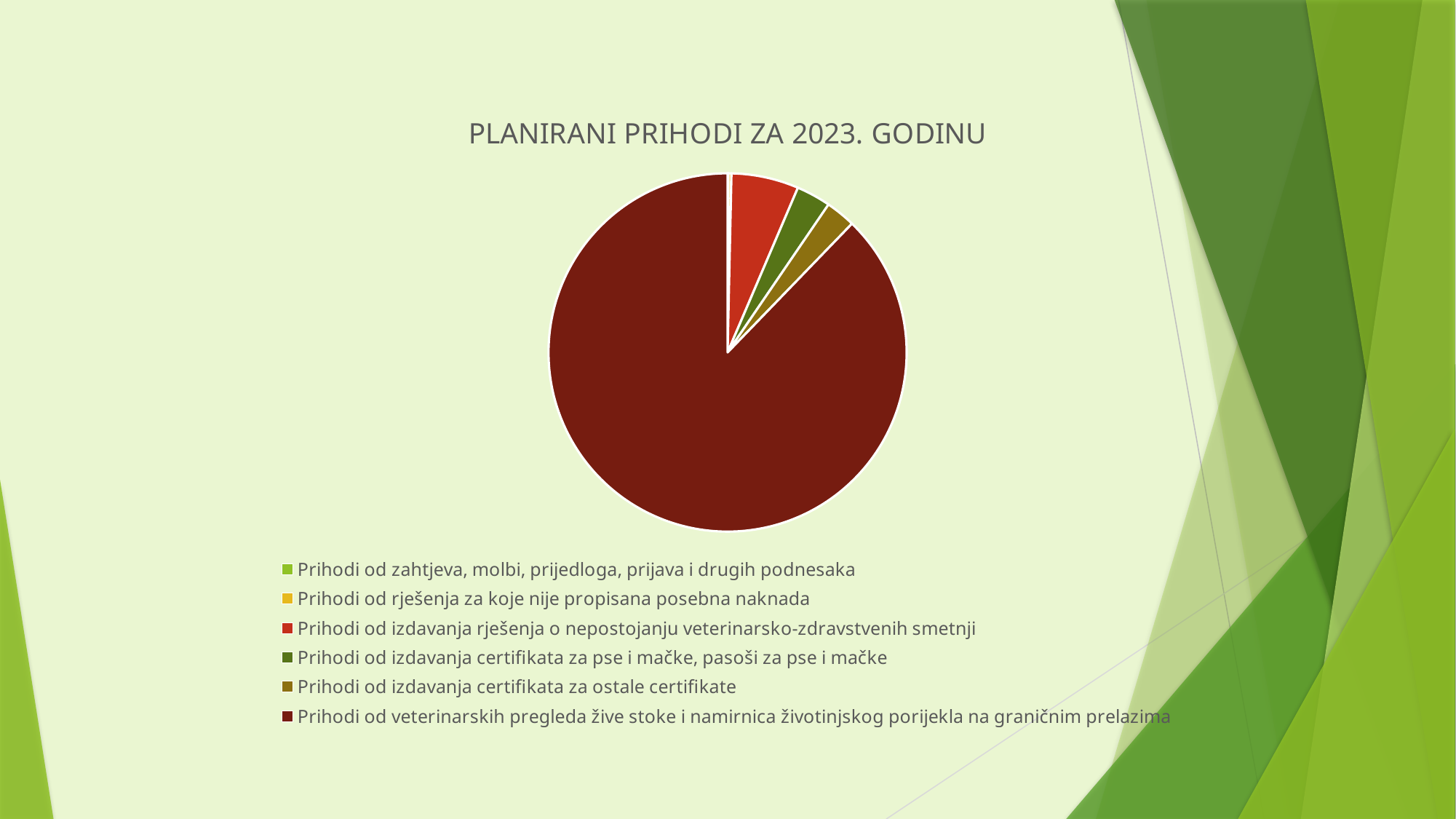
Which category has the largest slice of the pie? Prihodi od veterinarskih pregleda žive stoke i namirnica životinjskog porijekla na graničnim prelazima Which slice is larger: "Prihodi od izdavanja rješenja o nepostojanju veterinarsko-zdravstvenih smetnji" or "Prihodi od izdavanja certifikata za pse i mačke, pasoši za pse i mačke"? Prihodi od izdavanja rješenja o nepostojanju veterinarsko-zdravstvenih smetnji Which slice is larger: "Prihodi od veterinarskih pregleda žive stoke i namirnica životinjskog porijekla na graničnim prelazima" or "Prihodi od izdavanja rješenja o nepostojanju veterinarsko-zdravstvenih smetnji"? Prihodi od veterinarskih pregleda žive stoke i namirnica životinjskog porijekla na graničnim prelazima Does the largest slice of the pie take up more or less than half of the pie? More What kind of chart is shown on the slide? Pie chart What colour is the slice for "Prihodi od izdavanja rješenja o nepostojanju veterinarsko-zdravstvenih smetnji"? Red How many categories does the legend of the pie chart list? 6 What is the title of the chart? PLANIRANI PRIHODI ZA 2023. GODINU